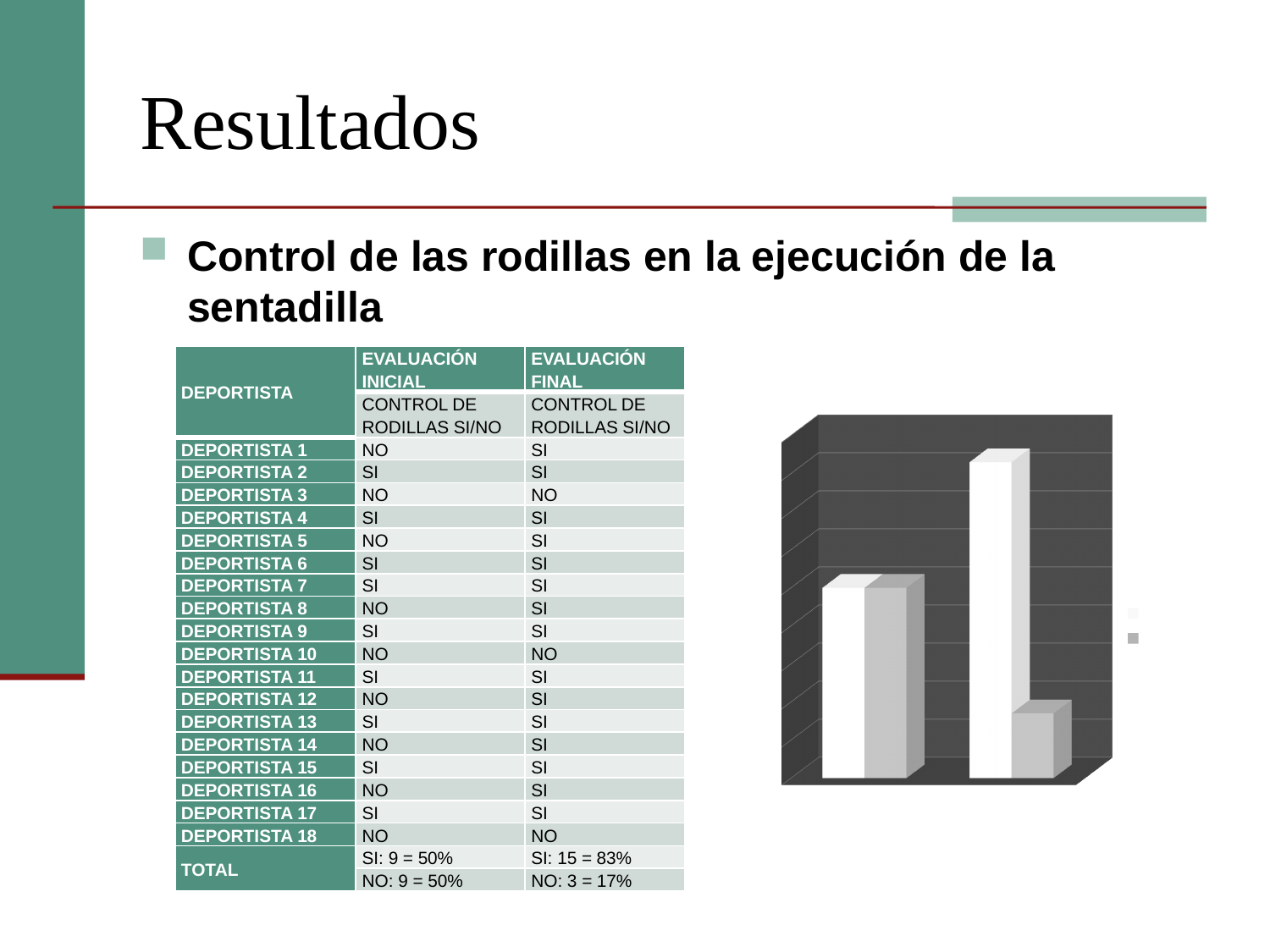
What kind of chart is shown on the right of the slide? bar chart Does the white series rise or fall from the left group to the right group? rises Which bar in the chart is the tallest? the white bar in the right-hand group How many groups of bars does the chart show? 2 How many series does the chart's legend list? 2 Which bar in the chart is the shortest? the grey bar in the right-hand group In the right-hand group of bars, which is taller, the white bar or the grey bar? the white bar What two colours are used for the bars in the chart? white and grey Does the grey series rise or fall from the left group to the right group? falls How many bars are plotted in the chart? 4 Is the chart drawn in 3D or flat 2D style? 3D